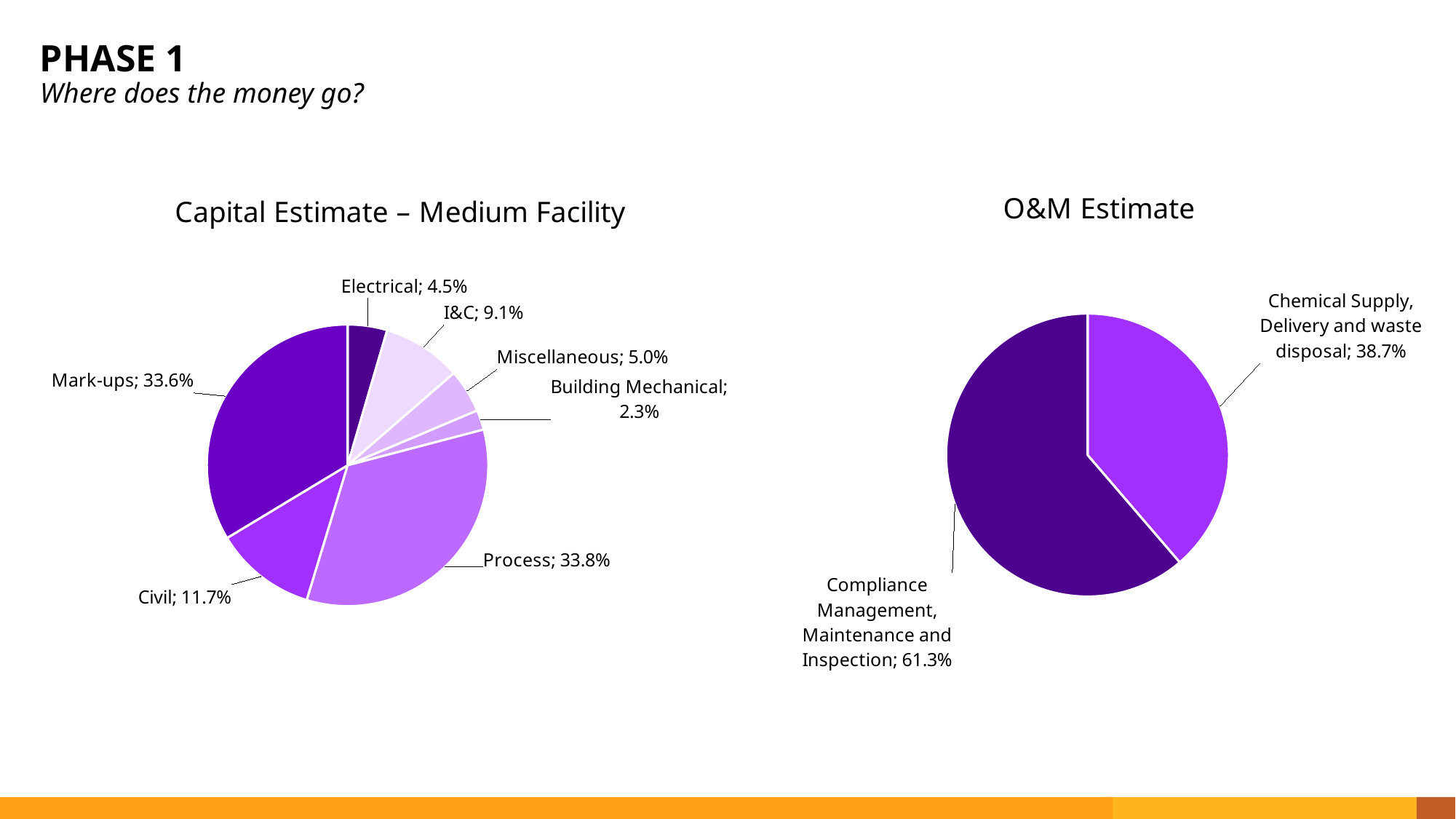
In the O&M Estimate chart, what is the difference between the two slices? 22.6% In the Capital Estimate – Medium Facility chart, what is the value for Building Mechanical? 2.3% In the Capital Estimate – Medium Facility chart, what percentage is shown for I&C? 9.1% How many categories are shown in the Capital Estimate – Medium Facility chart? 7 How many charts are on the slide? 2 In the Capital Estimate – Medium Facility chart, what share does Process account for? 33.8% In the Capital Estimate – Medium Facility chart, which is larger, Civil or I&C? Civil In the Capital Estimate – Medium Facility chart, which category has the smallest share? Building Mechanical In the O&M Estimate chart, which category has the largest share? Compliance Management, Maintenance and Inspection In the Capital Estimate – Medium Facility chart, what is the difference between the Mark-ups share and the Civil share? 21.9% In the O&M Estimate chart, what share is attributed to Compliance Management, Maintenance and Inspection? 61.3% What type of chart is the Capital Estimate – Medium Facility chart? Pie chart